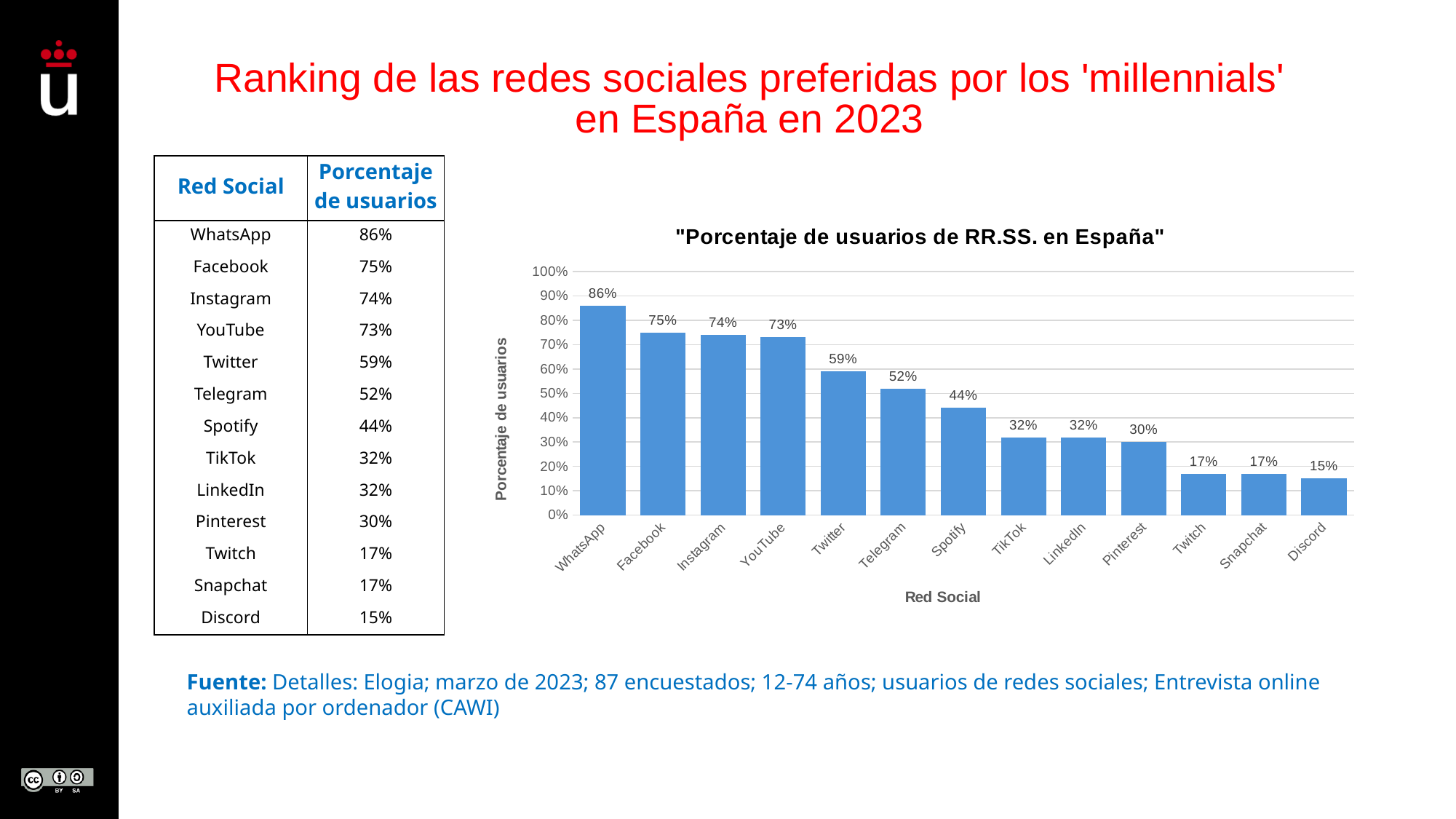
Which social network has the highest percentage of users? WhatsApp Is the value for Twitter greater or less than 50%? greater What is the difference between the values for Twitter and Spotify? 15% Which social network has the lowest percentage of users? Discord What is the difference between the values for WhatsApp and Facebook? 11% What is the value for WhatsApp? 86% How many social networks are shown on the chart? 13 Which has a larger value, Telegram or Spotify? Telegram What kind of chart is shown on the slide? Bar chart What is the value for Pinterest? 30% What is the title of the chart? "Porcentaje de usuarios de RR.SS. en España" What is the value for Telegram? 52%